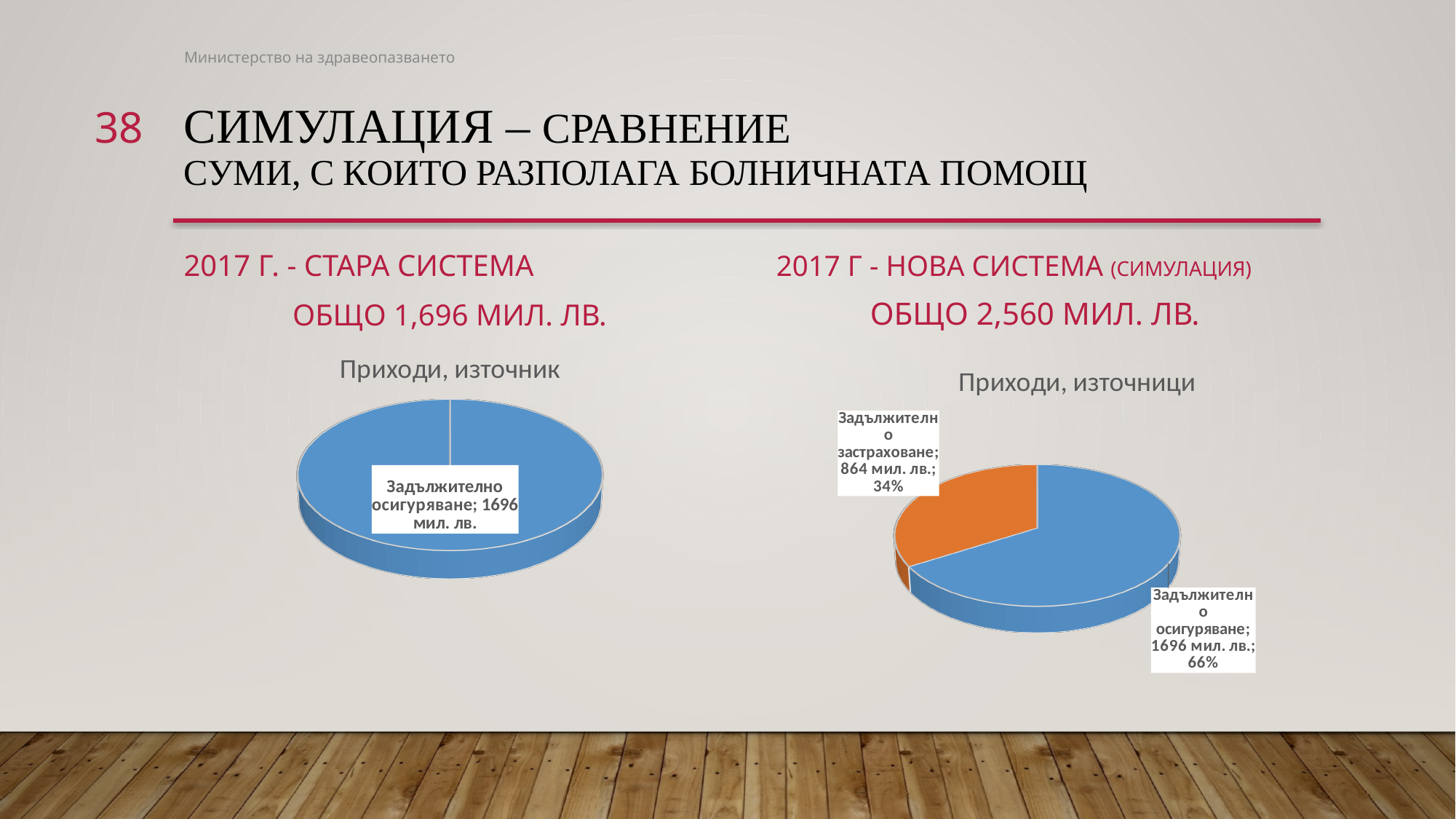
In the right chart "Приходи, източници", which slice is the largest? Задължително осигуряване In the right chart "Приходи, източници", what colour is the Задължително застраховане slice? orange How many slices does the right chart "Приходи, източници" have? 2 In the left chart "Приходи, източник", what value is shown for Задължително осигуряване? 1696 мил. лв. In the right chart "Приходи, източници", what value is shown for Задължително осигуряване? 1696 мил. лв. In the right chart "Приходи, източници", what is the difference between Задължително осигуряване and Задължително застраховане? 832 мил. лв. What kind of chart is the right chart titled "Приходи, източници"? pie chart In the right chart "Приходи, източници", what share of the pie is Задължително застраховане? 34% In the right chart "Приходи, източници", what value is shown for Задължително застраховане? 864 мил. лв. In the right chart "Приходи, източници", what share of the pie is Задължително осигуряване? 66% How many slices does the left chart "Приходи, източник" have? 1 What kind of chart is the left chart titled "Приходи, източник"? pie chart